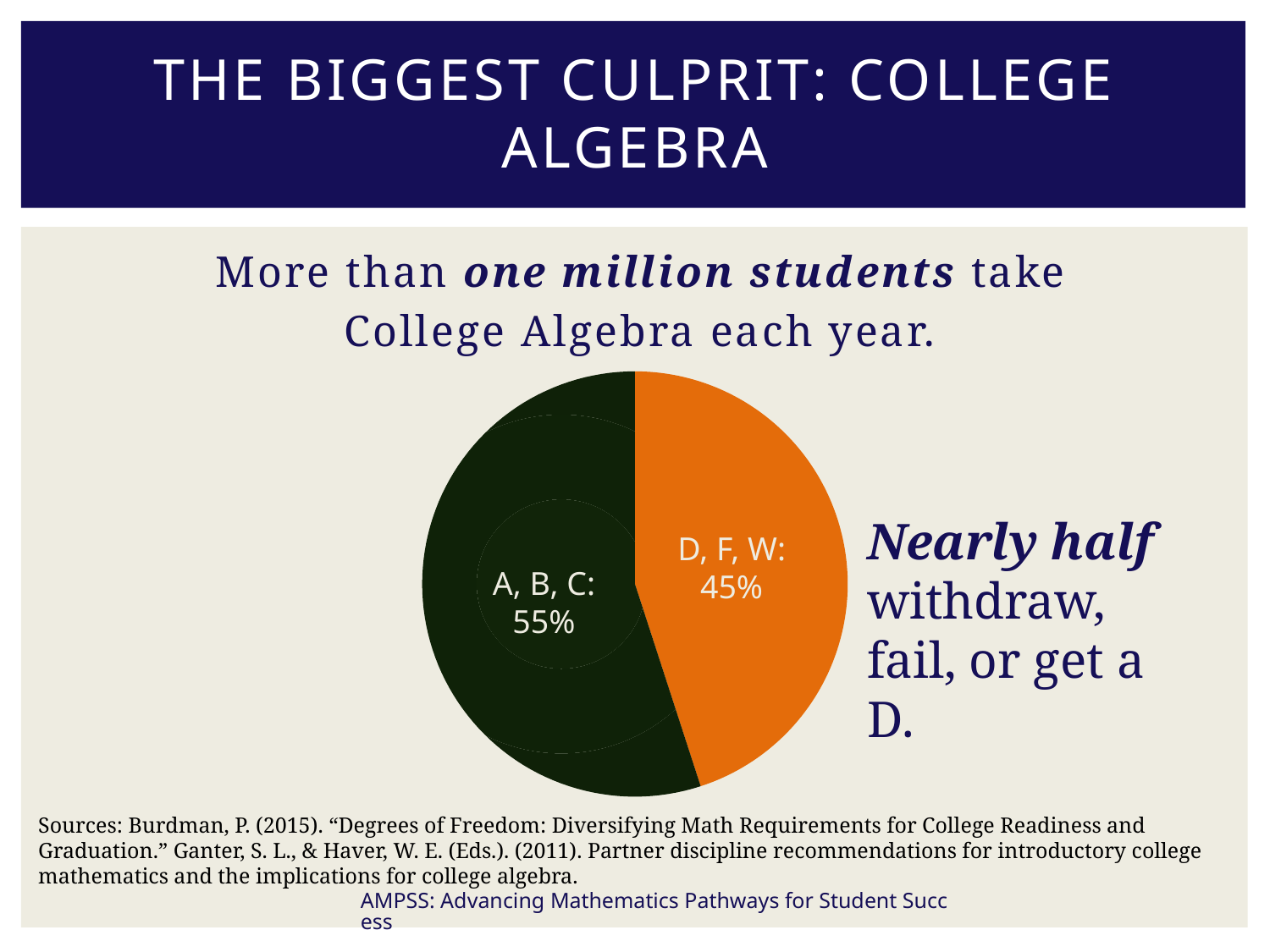
What colour is the "D, F, W" slice of the pie? orange Which slice of the pie is the smallest? D, F, W What is the difference in percentage points between the "A, B, C" slice and the "D, F, W" slice? 10 What share of the pie is labelled "D, F, W"? 45% What colour is the "A, B, C" slice of the pie? dark green How many slices does the pie chart have? 2 Is the value for "D, F, W" greater or less than 50%? less Which is larger, the "A, B, C" slice or the "D, F, W" slice? A, B, C What kind of chart is shown on the slide? pie chart Which slice of the pie is the largest? A, B, C What share of the pie is labelled "A, B, C"? 55%